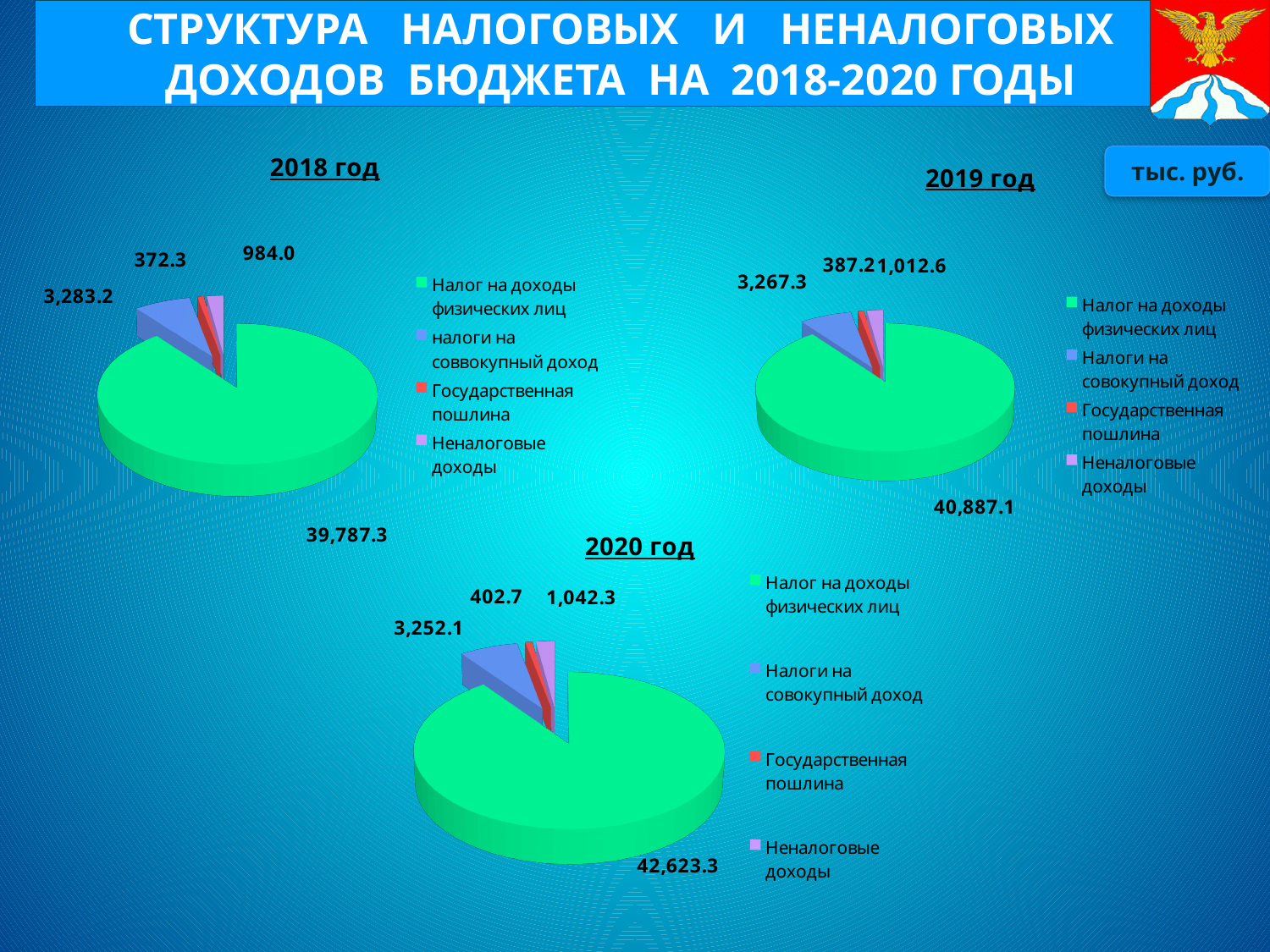
In the 2018 год chart, what is the difference between Налоги на совокупный доход and Государственная пошлина? 2,910.9 In the 2019 год chart, what is the value for Неналоговые доходы? 1,012.6 In the 2020 год chart, which category has the smallest value? Государственная пошлина How many categories does the legend of the 2020 год chart list? 4 What unit is stated for the values on the slide? тыс. руб. In the 2018 год chart, what is the value for Налог на доходы физических лиц? 39,787.3 What kind of chart is used for the 2018 год data? Pie chart In the 2019 год chart, what is the value for Налоги на совокупный доход? 3,267.3 In the 2018 год chart, what is the value for Государственная пошлина? 372.3 In the 2020 год chart, what is the value for Налог на доходы физических лиц? 42,623.3 In the 2019 год chart, which category has the largest value? Налог на доходы физических лиц Which is larger: Неналоговые доходы in the 2020 год chart or Неналоговые доходы in the 2018 год chart? 2020 год (1,042.3)